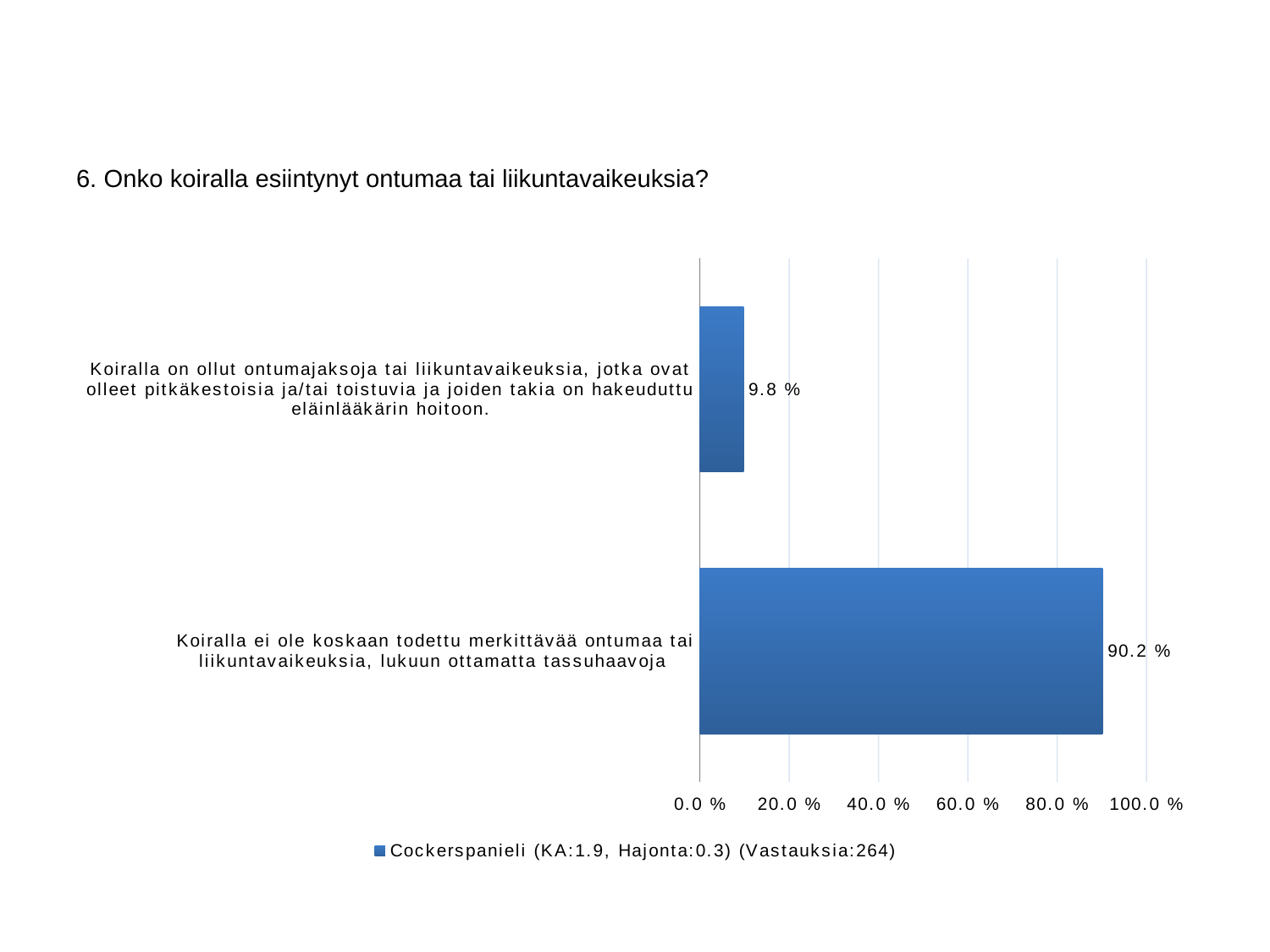
Is the value for 'Koiralla on ollut ontumajaksoja tai liikuntavaikeuksia' greater or less than 20.0 %? less Which is larger: the value for dogs that have never had significant lameness (ei ole koskaan todettu) or the value for dogs that have had lameness episodes (on ollut ontumajaksoja)? Koiralla ei ole koskaan todettu merkittävää ontumaa tai liikuntavaikeuksia, lukuun ottamatta tassuhaavoja What percentage is shown for the category 'Koiralla on ollut ontumajaksoja tai liikuntavaikeuksia, jotka ovat olleet pitkäkestoisia ja/tai toistuvia ja joiden takia on hakeuduttu eläinlääkärin hoitoon.'? 9.8 % How many categories are shown in the chart? 2 How many series does the legend list? 1 What is the difference between the two bar values? 80.4 % What percentage is shown for the category 'Koiralla ei ole koskaan todettu merkittävää ontumaa tai liikuntavaikeuksia, lukuun ottamatta tassuhaavoja'? 90.2 % Which category has the lowest value? Koiralla on ollut ontumajaksoja tai liikuntavaikeuksia, jotka ovat olleet pitkäkestoisia ja/tai toistuvia ja joiden takia on hakeuduttu eläinlääkärin hoitoon. What is the legend entry of the chart? Cockerspanieli (KA:1.9, Hajonta:0.3) (Vastauksia:264) What kind of chart is shown on the slide? Bar chart Which category has the highest value? Koiralla ei ole koskaan todettu merkittävää ontumaa tai liikuntavaikeuksia, lukuun ottamatta tassuhaavoja Is the value for 'Koiralla ei ole koskaan todettu merkittävää ontumaa tai liikuntavaikeuksia' greater or less than 80.0 %? greater